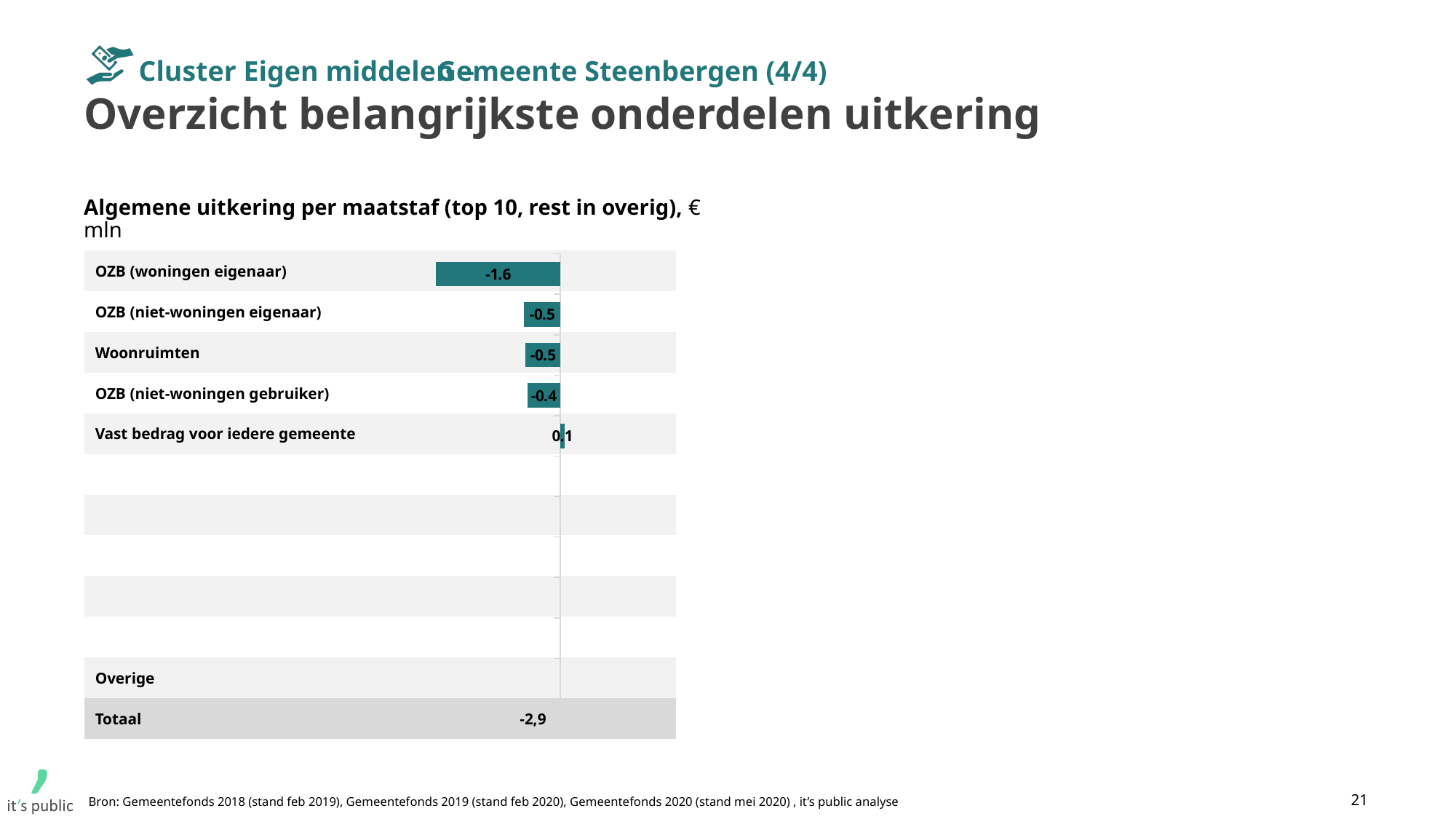
What is the value for Vast bedrag voor iedere gemeente? 0.1 How many bars with data labels are plotted in the chart? 5 Which has the higher value: OZB (woningen eigenaar) or OZB (niet-woningen eigenaar)? OZB (niet-woningen eigenaar) What is the difference between the values for OZB (woningen eigenaar) and OZB (niet-woningen gebruiker)? 1.2 What is the value for OZB (niet-woningen gebruiker)? -0.4 What kind of chart is shown on the slide? Bar chart What is the title of the chart? Algemene uitkering per maatstaf (top 10, rest in overig), € mln What is the value shown for Totaal? -2,9 Which category has the lowest (most negative) value? OZB (woningen eigenaar) What is the value for OZB (woningen eigenaar)? -1.6 Which category has the highest value? Vast bedrag voor iedere gemeente What is the value for Woonruimten? -0.5